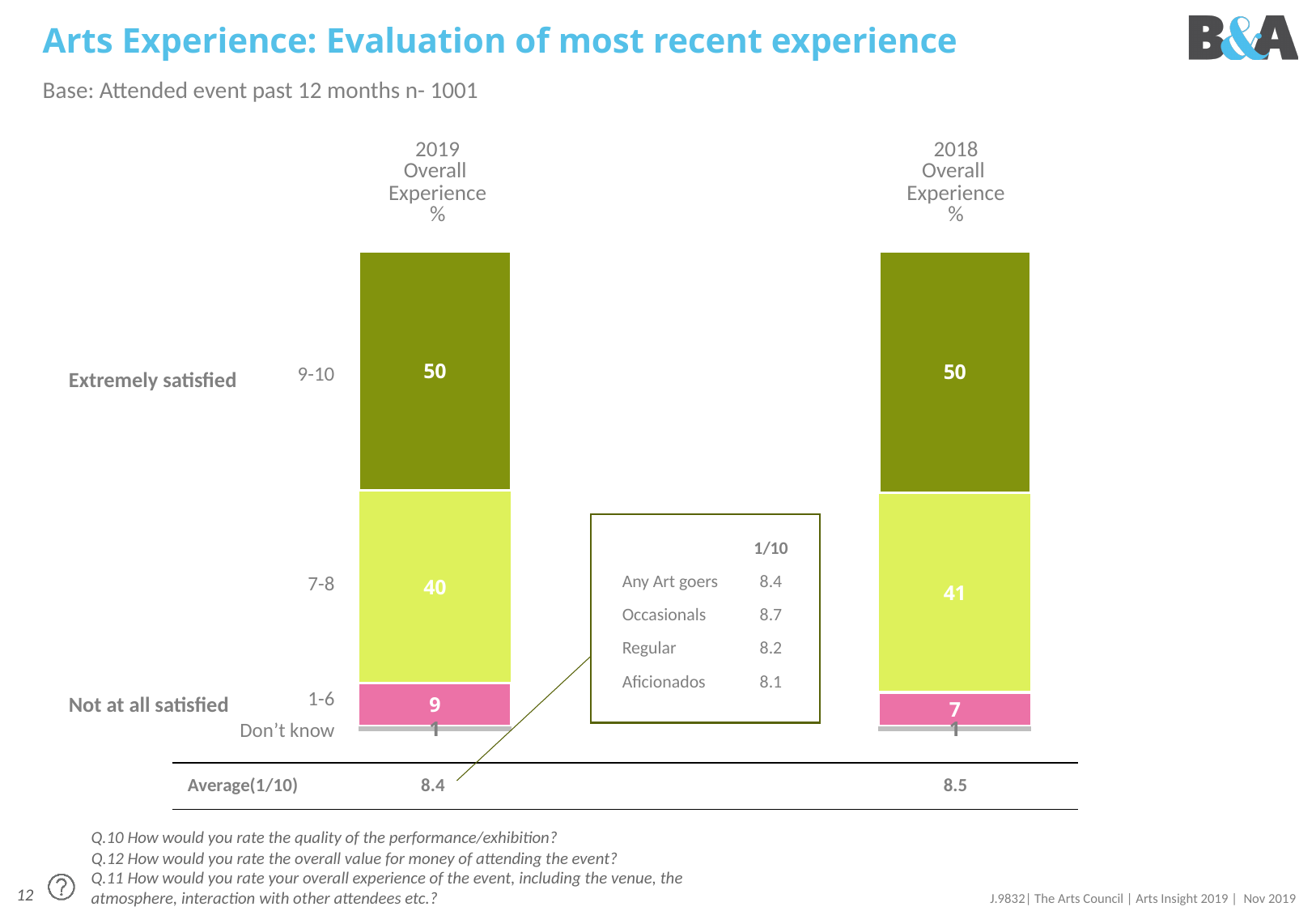
What is the difference between the 1-6 percentages for 2019 and 2018? 2 What type of chart is shown on the slide? Stacked bar chart What percentage of respondents rated their 2019 overall experience 9-10? 50 Which rating band has the largest share in the 2019 Overall Experience bar? 9-10 Is the 7-8 percentage larger in 2019 or 2018? 2018 What is the 'Don't know' percentage for the 2018 overall experience? 1 How many rating bands are stacked in each bar? 4 What is the total of the 2019 Overall Experience stacked bar? 100 What percentage of respondents rated their 2019 overall experience 1-6? 9 Which rating band has the smallest share in the 2018 Overall Experience bar? Don't know What is the Average (1/10) score shown for 2018? 8.5 What percentage of respondents rated their 2018 overall experience 7-8? 41